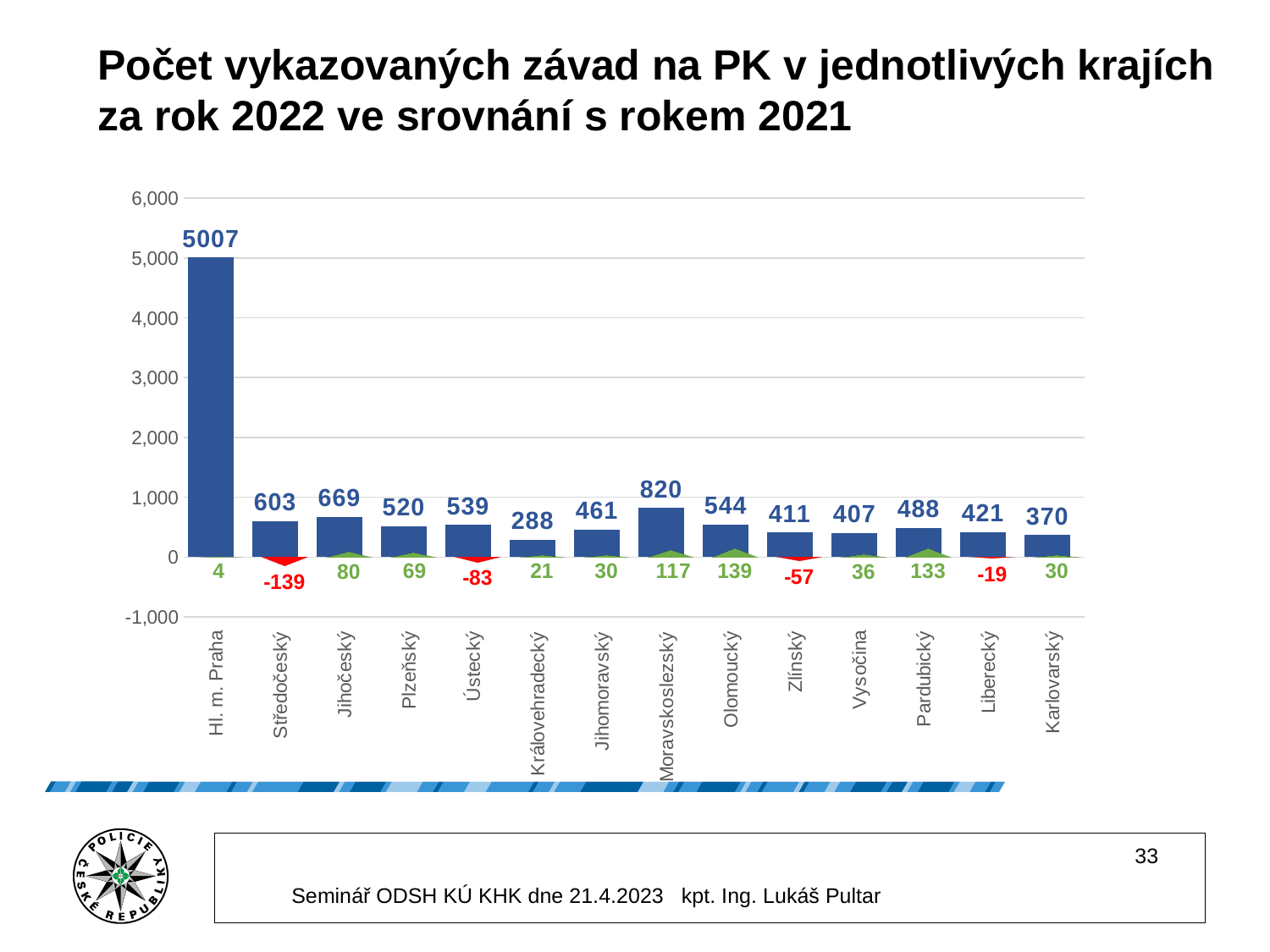
What kind of chart is shown on the slide? bar chart What is the value of the bar for Královehradecký? 288 Is the bar value for Hl. m. Praha greater or less than 4,000? greater What is the difference between the bar values for Moravskoslezský and Olomoucký? 276 Which region has the lowest bar? Královehradecký How many regions are shown on the x axis? 14 What is the value of the bar for Moravskoslezský? 820 What is the green/red change value shown below the bar for Olomoucký? 139 Which has a larger bar value, Jihočeský or Středočeský? Jihočeský What is the value of the bar for Hl. m. Praha? 5007 Which region has the highest bar? Hl. m. Praha What is the green/red change value shown below the bar for Středočeský? -139